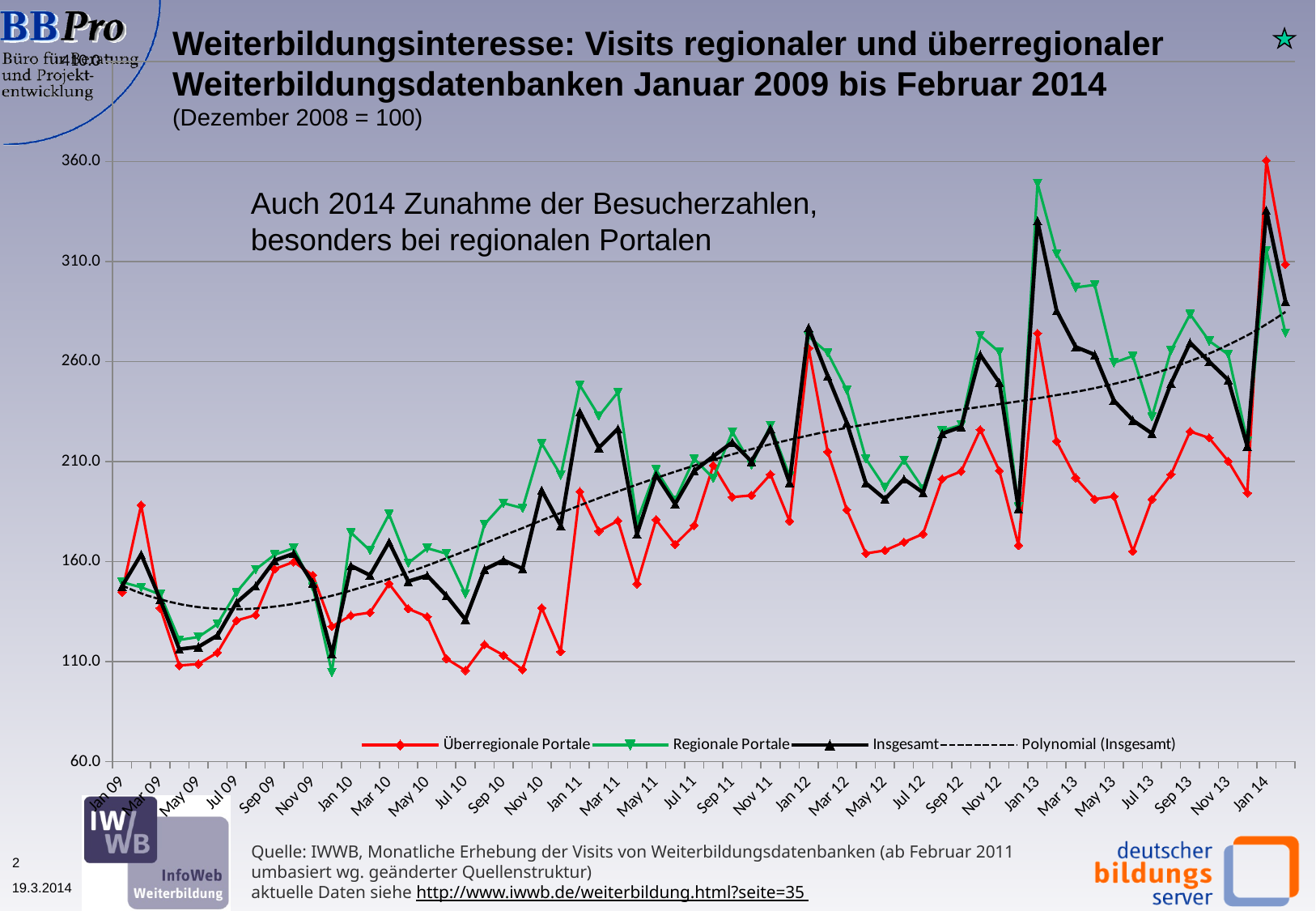
What colour is the line for Regionale Portale? green In Jan 13, which series has the higher value: Regionale Portale or Überregionale Portale? Regionale Portale In Jan 14, which series has the higher value: Überregionale Portale or Regionale Portale? Überregionale Portale Overall, does the Insgesamt series rise or fall from Jan 09 to Jan 14? rise Which series is drawn as a dashed line? Polynomial (Insgesamt) Which series reaches the highest point anywhere on the chart? Überregionale Portale How many entries does the chart legend list? 4 Is the value for Regionale Portale in Jan 10 greater or less than 110? greater What kind of chart is shown on the slide? line chart Is the value for Insgesamt in Jan 11 greater or less than 210? greater Is the value for Regionale Portale in Jan 13 greater or less than 310? greater